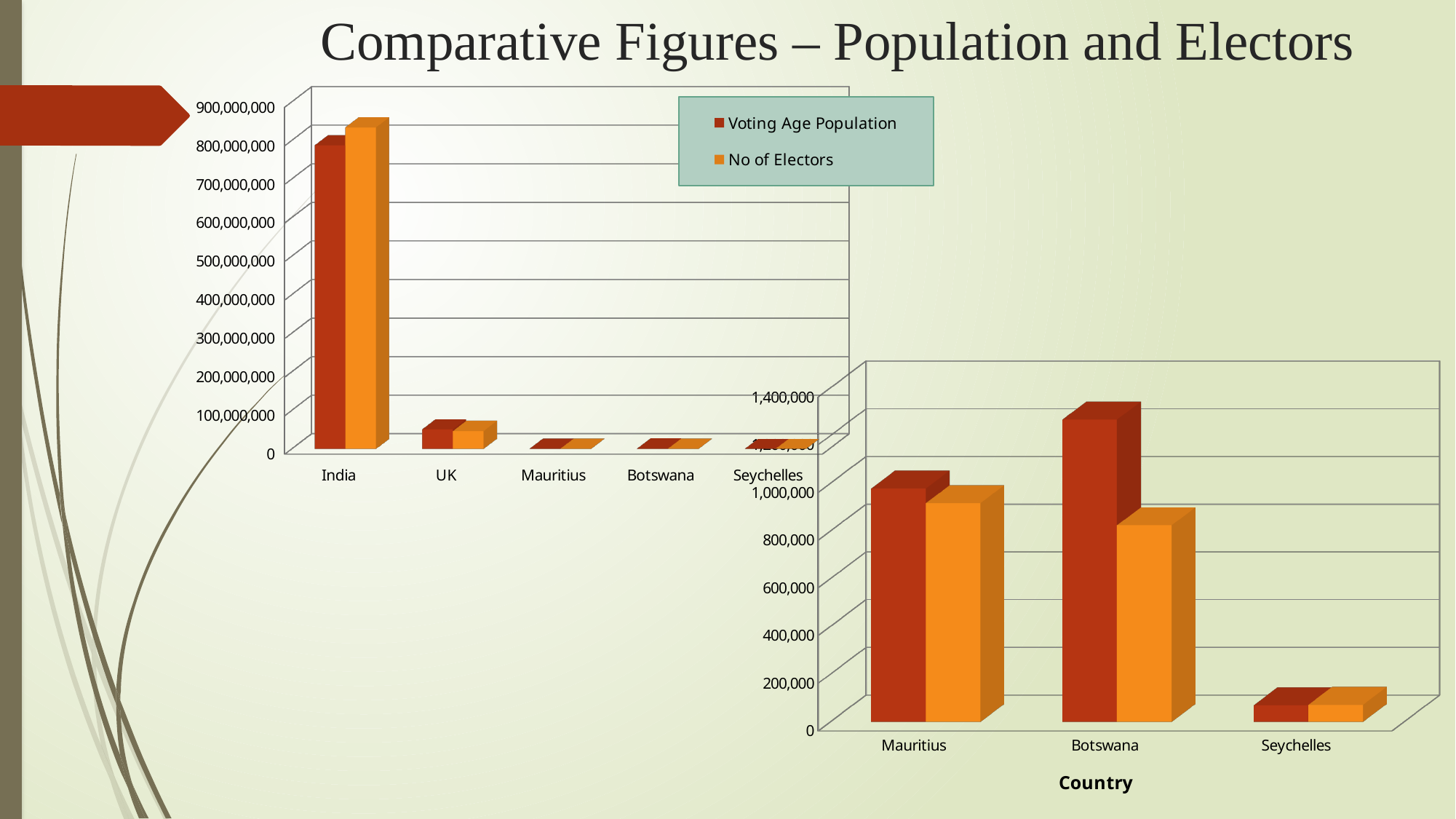
What kind of chart is the top-left chart on the slide? bar chart On the bottom-right chart, which country has the highest Voting Age Population? Botswana On the bottom-right chart, which is larger for Botswana: Voting Age Population or No of Electors? Voting Age Population What is the x-axis title of the bottom-right chart? Country On the top-left chart, is the Voting Age Population for India greater or less than 700,000,000? greater On the top-left chart, which country has the highest Voting Age Population? India On the top-left chart, is the Voting Age Population for UK greater or less than 100,000,000? less On the bottom-right chart, which country has the lowest No of Electors? Seychelles On the bottom-right chart, is the Voting Age Population for Botswana greater or less than 1,200,000? greater How many countries are shown on the top-left chart? 5 How many countries are shown on the bottom-right chart? 3 How many series does the legend list? 2